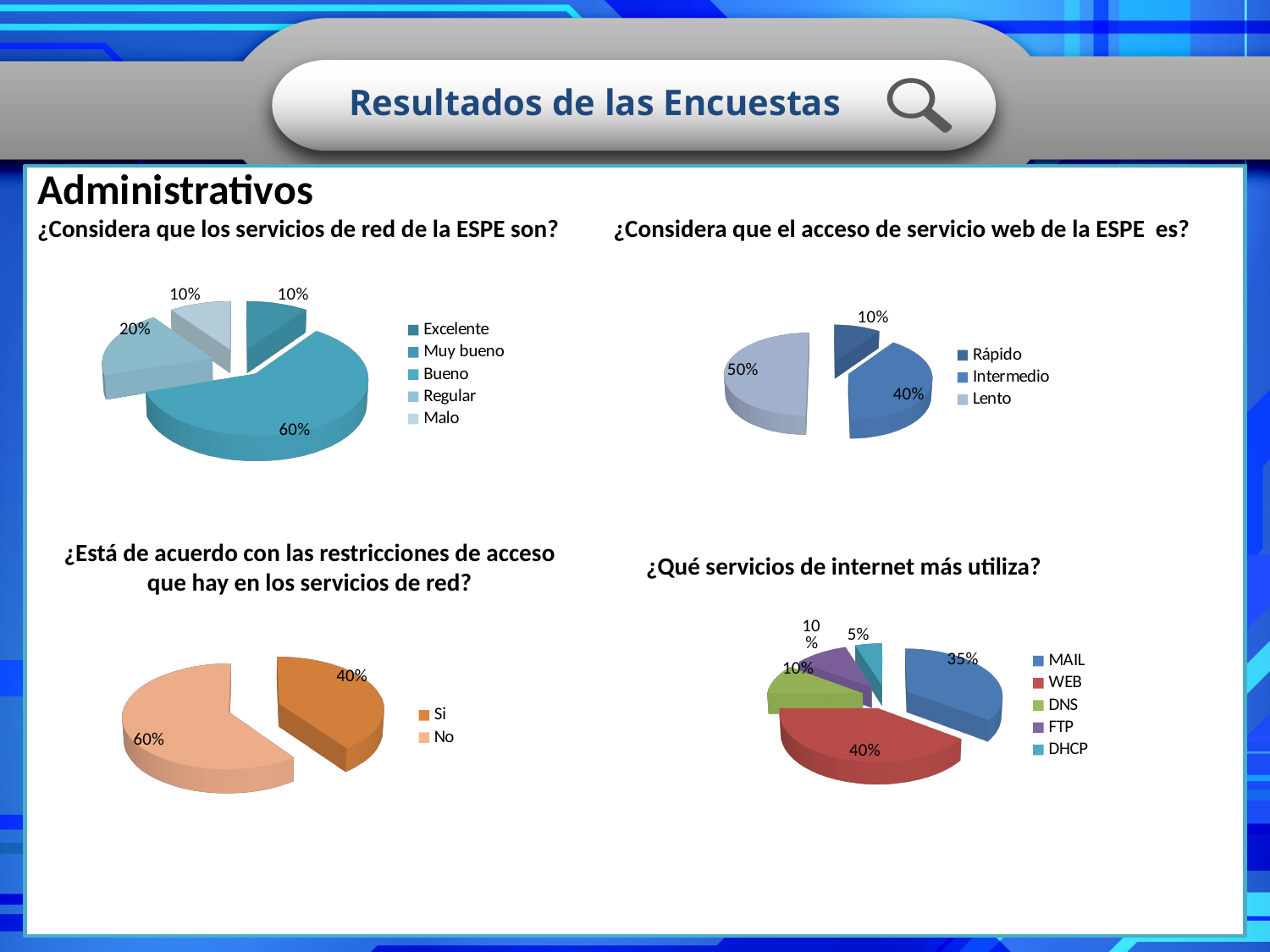
In the chart '¿Considera que el acceso de servicio web de la ESPE es?', which category has the largest share? Lento In the chart '¿Qué servicios de internet más utiliza?', what percentage is MAIL? 35% In the chart '¿Qué servicios de internet más utiliza?', which service has the largest share? WEB What kind of chart is used for '¿Qué servicios de internet más utiliza?'? Pie chart In the chart '¿Está de acuerdo con las restricciones de acceso que hay en los servicios de red?', what percentage answered No? 60% In the chart '¿Está de acuerdo con las restricciones de acceso que hay en los servicios de red?', what is the difference between No and Si? 20% In the chart '¿Considera que los servicios de red de la ESPE son?', what percentage is Bueno? 60% In the chart '¿Qué servicios de internet más utiliza?', which service has the smallest share? DHCP In the chart '¿Considera que los servicios de red de la ESPE son?', how many entries does the legend list? 5 In the chart '¿Considera que el acceso de servicio web de la ESPE es?', what percentage is Rápido? 10% In the chart '¿Considera que los servicios de red de la ESPE son?', what percentage is Regular? 20% In the chart '¿Considera que el acceso de servicio web de la ESPE es?', what percentage is Lento? 50%